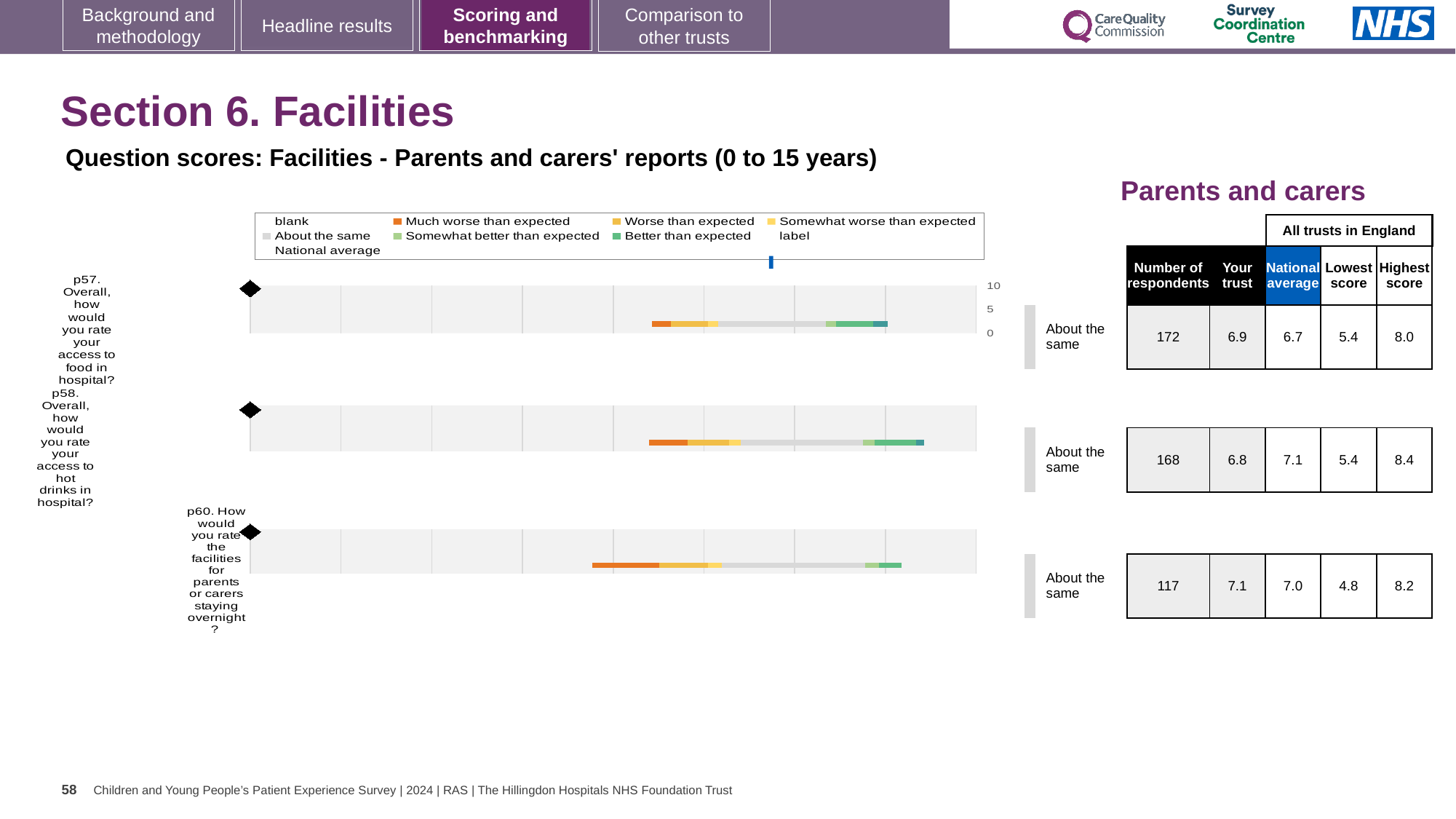
How many questions (bars) are plotted on the slide? 3 What benchmark category is shown for all three questions on this slide? About the same What is the highest score across all trusts in England for p58? 8.4 For p57, is the 'Your trust' score higher or lower than the national average? higher Is the 'Your trust' score for p60 greater or less than 5? greater Which question has the fewest respondents? p60 What is the national average score for p58 (access to hot drinks in hospital)? 7.1 What kind of chart is used to show the question scores on this slide? bar chart What is the 'Your trust' score for p57 (access to food in hospital)? 6.9 How many respondents answered p60 (facilities for parents or carers staying overnight)? 117 What is the difference between the highest score and the lowest score for p57? 2.6 Which question has the lowest 'Lowest score' across all trusts in England? p60